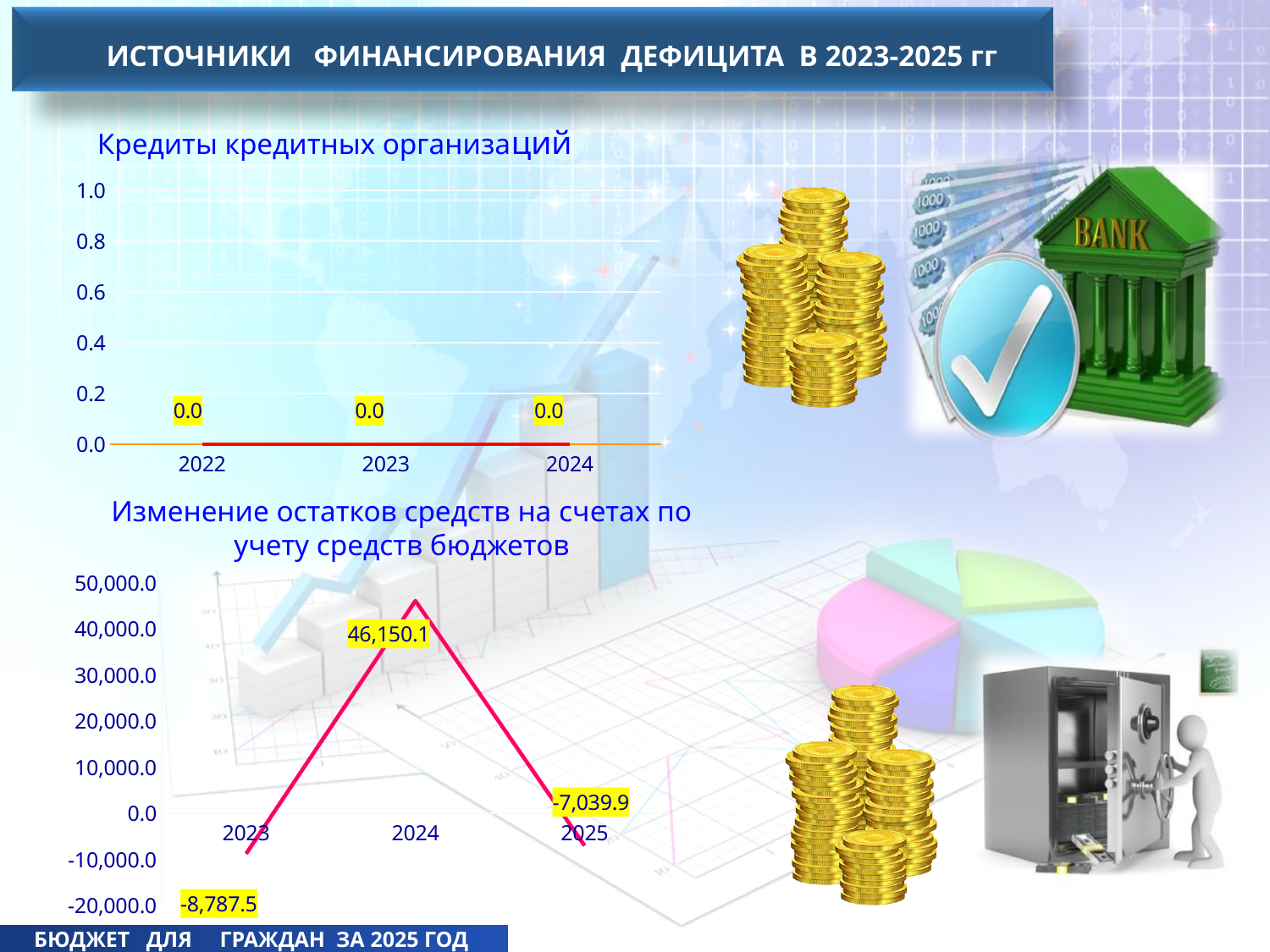
In the chart titled "Изменение остатков средств на счетах по учету средств бюджетов", what is the difference between the values for 2024 and 2025? 53,190.0 What kind of chart is the top chart, "Кредиты кредитных организаций"? line chart In the chart titled "Изменение остатков средств на счетах по учету средств бюджетов", what is the value for 2023? -8,787.5 In the chart titled "Изменение остатков средств на счетах по учету средств бюджетов", is the value for 2024 greater or less than 40,000.0? greater In the chart titled "Изменение остатков средств на счетах по учету средств бюджетов", which year has the lowest value? 2023 In the chart titled "Изменение остатков средств на счетах по учету средств бюджетов", what is the value for 2024? 46,150.1 In the chart titled "Изменение остатков средств на счетах по учету средств бюджетов", which year has the highest value? 2024 In the chart titled "Кредиты кредитных организаций", what is the value for 2023? 0.0 In the chart titled "Изменение остатков средств на счетах по учету средств бюджетов", which is larger, the value for 2023 or the value for 2025? 2025 In the chart titled "Кредиты кредитных организаций", how many years are plotted on the x axis? 3 In the chart titled "Изменение остатков средств на счетах по учету средств бюджетов", what is the value for 2025? -7,039.9 What kind of chart is the bottom chart, "Изменение остатков средств на счетах по учету средств бюджетов"? line chart